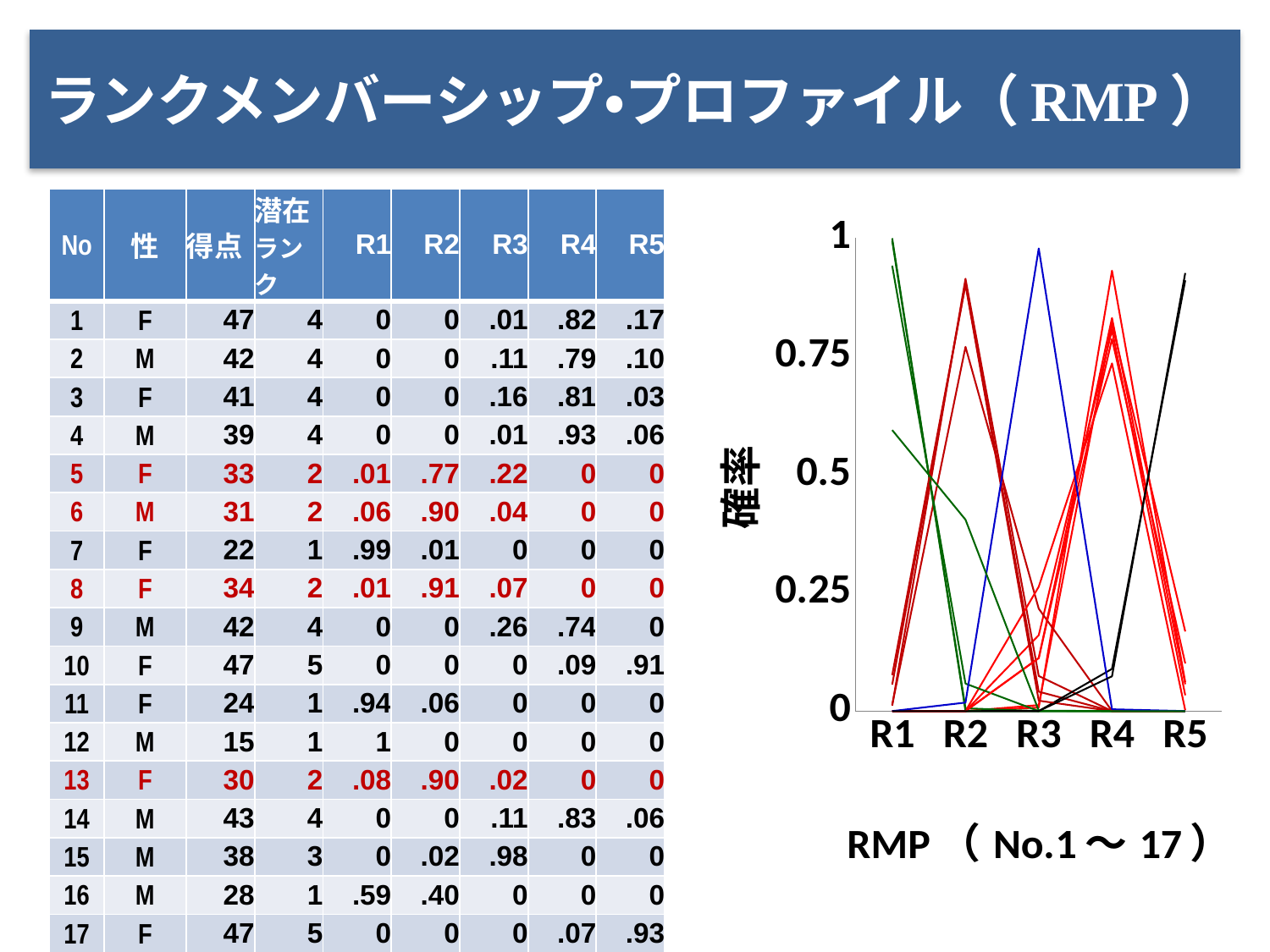
What is the lowest tick value shown on the y axis of the chart? 0 What kind of chart is shown on the right side of the slide? line chart At which x-axis category does the blue line reach its peak? R3 Does the blue line rise or fall from R3 to R4? fall What is the highest tick value shown on the y axis of the chart? 1 What is the caption printed below the chart? RMP（No.1～17） Does the black line rise or fall from R4 to R5? rise What is the label on the y axis of the chart? 確率 How many categories are shown on the x axis of the chart? 5 At which x-axis category does the black line reach its peak? R5 Is the peak value of the blue line at R3 greater or less than 0.75? greater Is the value of the black line at R5 greater or less than 0.75? greater